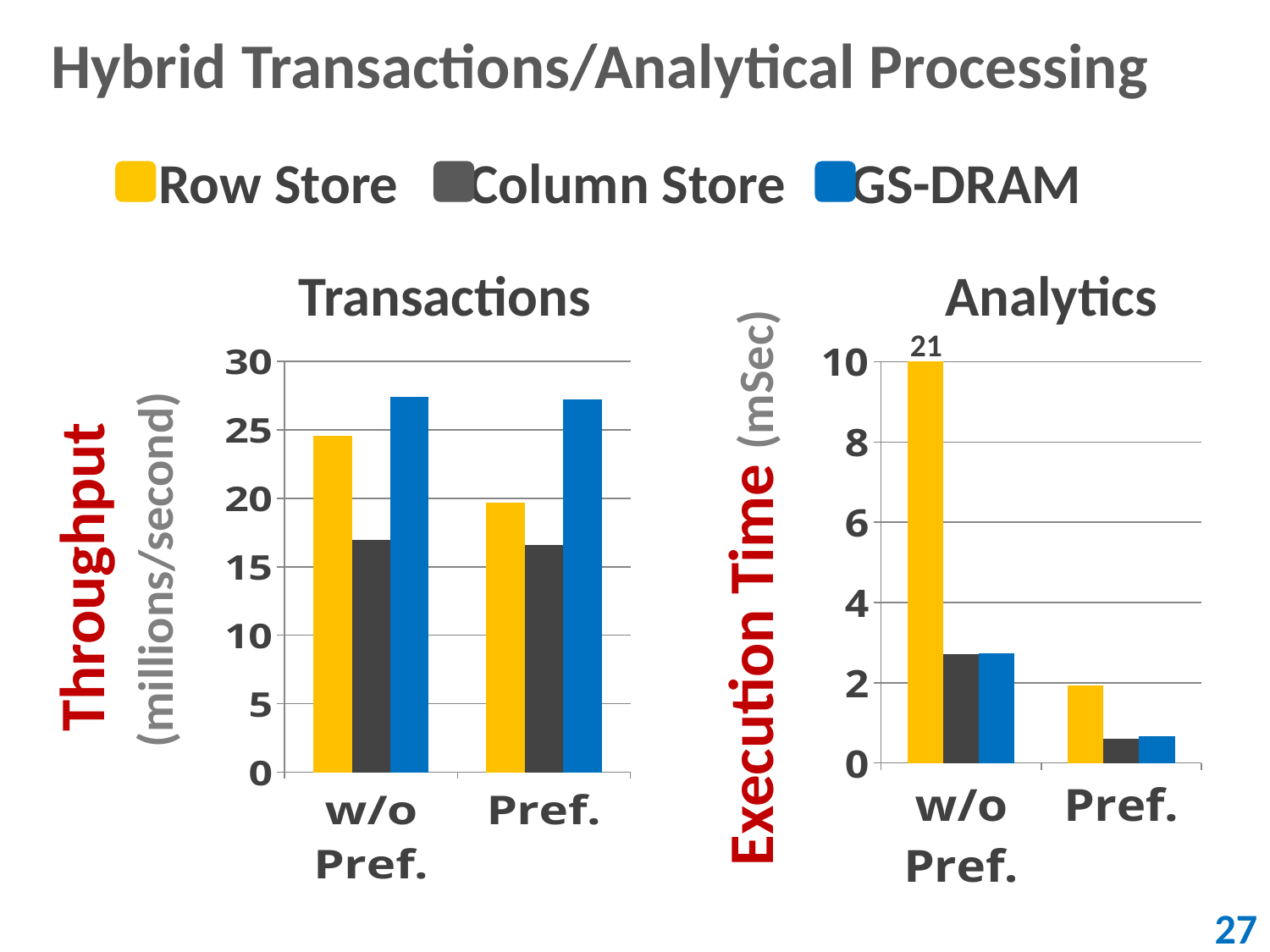
How many categories are shown on the x axis of the Analytics chart? 2 In the Transactions chart, is the throughput for GS-DRAM w/o Pref. greater or less than 25? greater In the Analytics chart, which series has the highest execution time for w/o Pref.? Row Store What kind of chart is the Transactions chart? Bar chart In the Transactions chart, which series has the lowest throughput for Pref.? Column Store In the Analytics chart, what is the execution time for Row Store without prefetching (w/o Pref.)? 21 In the Transactions chart, is the throughput for Column Store Pref. greater or less than 20? less How many series does the legend list? 3 In the Analytics chart, is the execution time for Column Store w/o Pref. greater or less than 4? less In the Transactions chart, which is larger for Pref.: Row Store or Column Store? Row Store In the Transactions chart, which series has the highest throughput for w/o Pref.? GS-DRAM